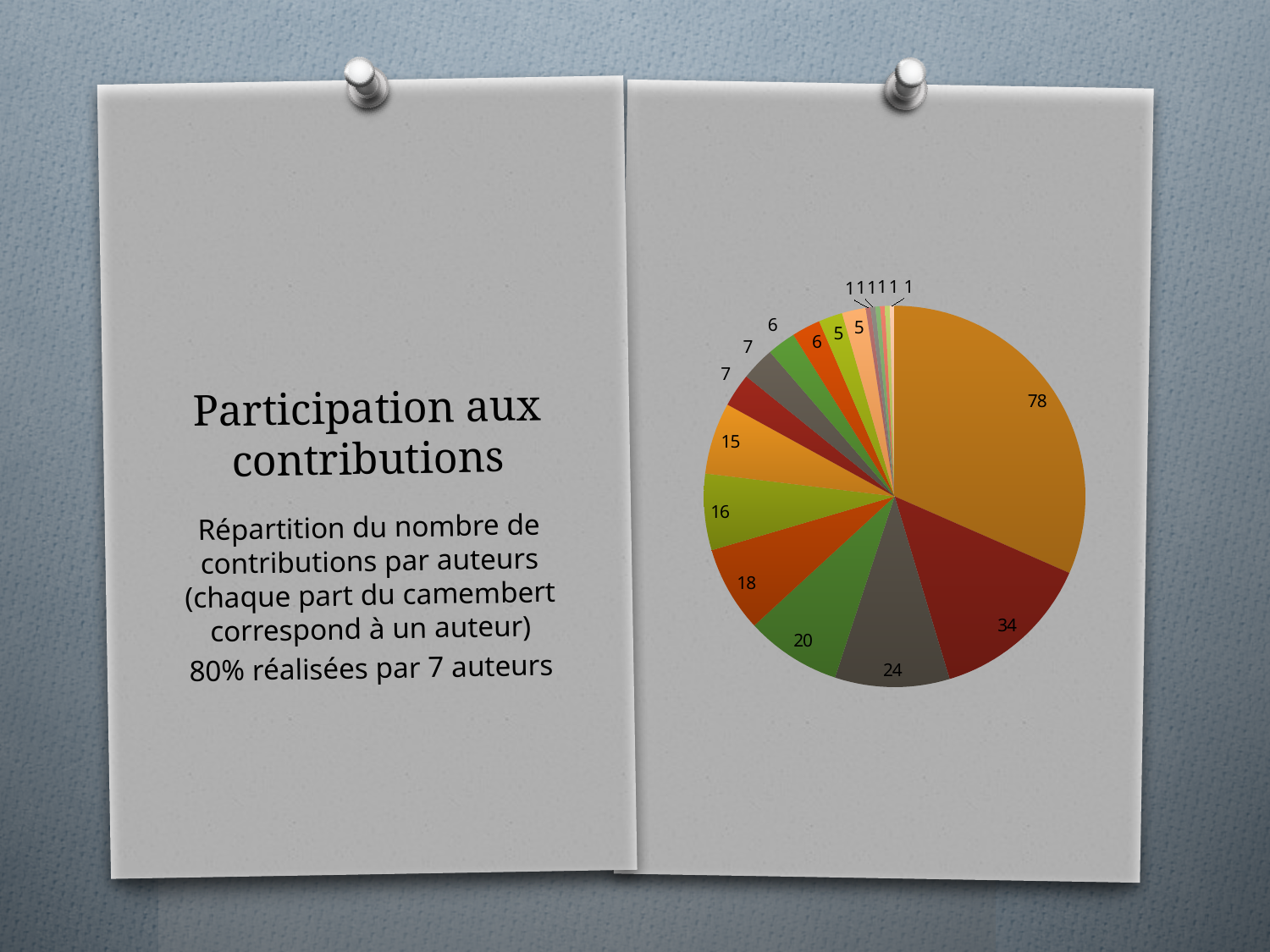
What is the difference between the slice labelled 24 and the slice labelled 20? 4 What is the difference between the largest slice (78) and the second-largest slice (34)? 44 What is the value of the largest slice in the pie chart? 78 What is the value of the grey slice at the bottom of the pie chart? 24 Which is larger: the dark red slice or the grey slice at the bottom of the pie? the dark red slice (34) What kind of chart is shown on the slide? pie chart What is the title of the slide containing the pie chart? Participation aux contributions How many slices in the pie chart have a value of 15 or more? 7 What is the value of the second-largest slice (the dark red one) in the pie chart? 34 What is the combined value of the three largest slices (78, 34 and 24)? 136 According to the slide text, how many authors account for 80% of the contributions? 7 What is the value of the smallest slices in the pie chart? 1